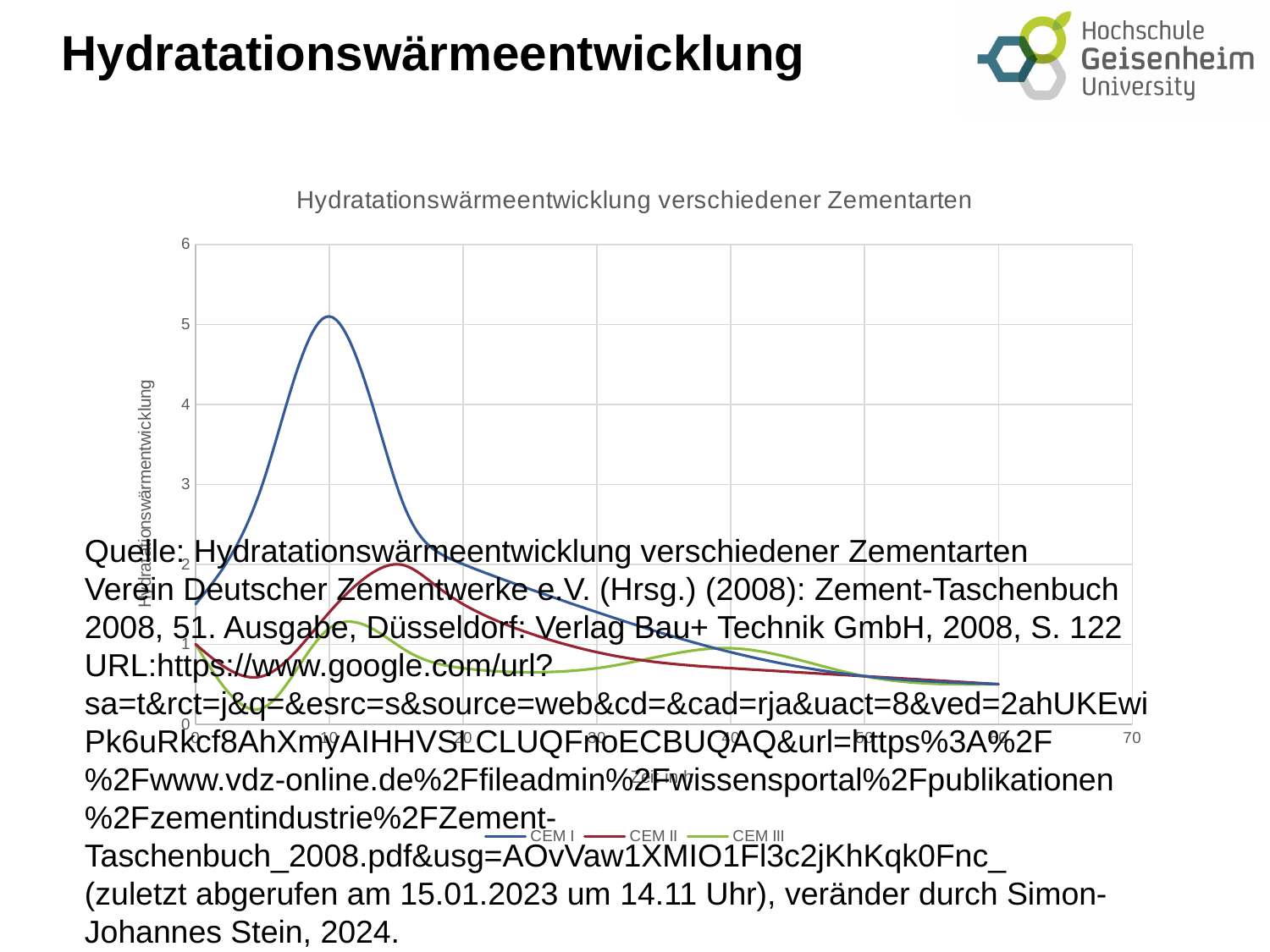
What kind of chart is shown on the slide? line chart Is the peak value of the CEM III line greater or less than 2? less Is the peak value of the CEM I line greater or less than 4? greater Which series reaches the highest peak value in the chart? CEM I What is the title of the chart? Hydratationswärmeentwicklung verschiedener Zementarten At x = 10, which series has the larger value, CEM I or CEM III? CEM I Is the peak value of the CEM II line greater or less than 3? less How many series does the legend of the chart list? 3 What is the highest value shown on the y axis of the chart? 6 Which series are listed in the chart's legend? CEM I, CEM II, CEM III Does the CEM I line rise or fall between x = 10 and x = 30? fall Which series has the lowest peak value in the chart? CEM III